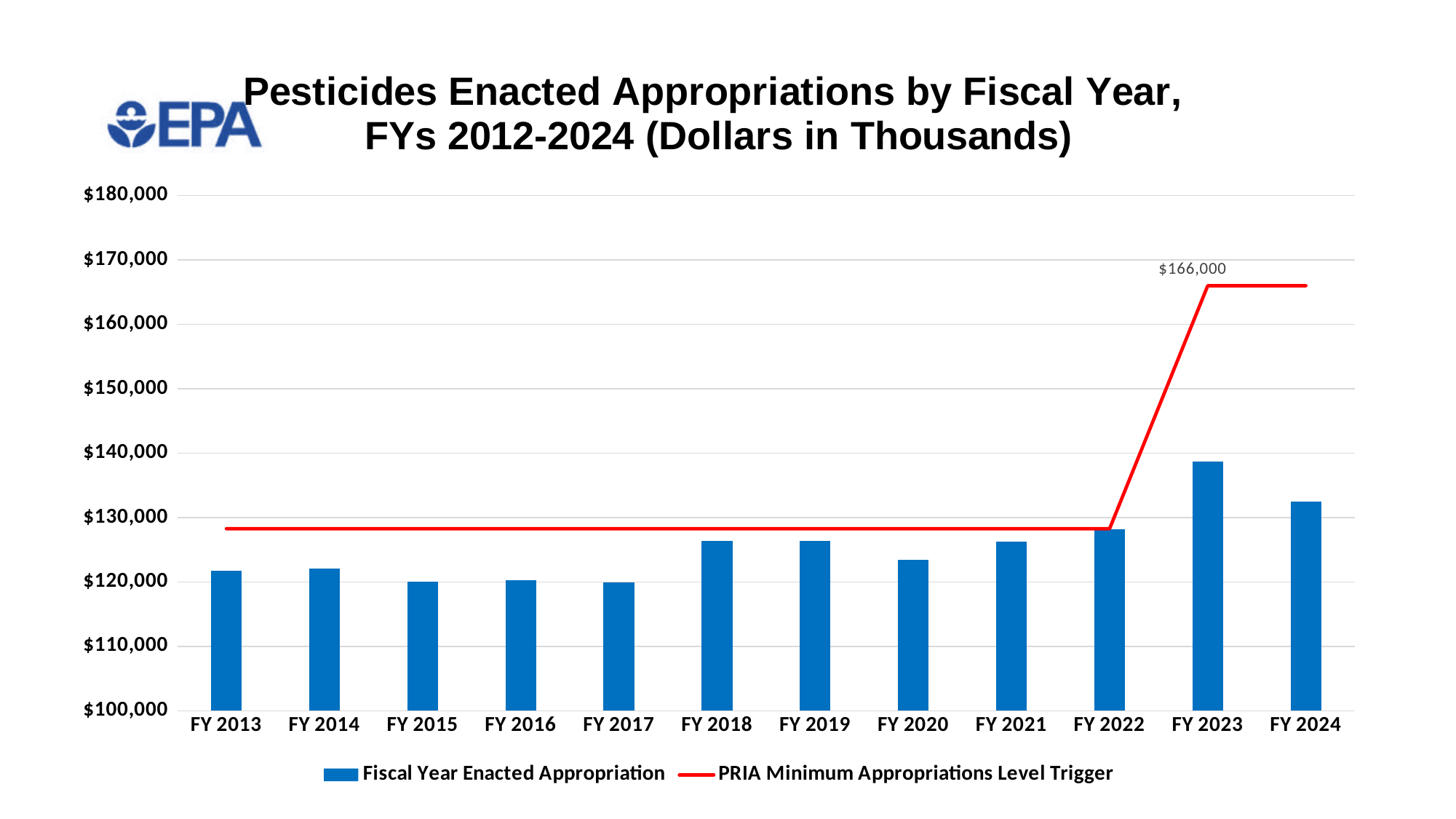
How many fiscal years are shown on the x axis? 12 Is the enacted appropriation for FY 2023 greater or less than $130,000? greater Which fiscal year has the larger enacted appropriation, FY 2018 or FY 2020? FY 2018 Which fiscal year has the highest enacted appropriation bar? FY 2023 Is the enacted appropriation for FY 2015 greater or less than $130,000? less Is the enacted appropriation for FY 2024 greater or less than $130,000? greater What kind of chart is used to show the Fiscal Year Enacted Appropriation series? bar chart What colour is the PRIA Minimum Appropriations Level Trigger line? red What is the PRIA Minimum Appropriations Level Trigger value labelled for FY 2023 and FY 2024? $166,000 How many series does the legend list? 2 Does the PRIA Minimum Appropriations Level Trigger line rise or fall between FY 2022 and FY 2023? rise Which fiscal year has the larger enacted appropriation, FY 2023 or FY 2024? FY 2023